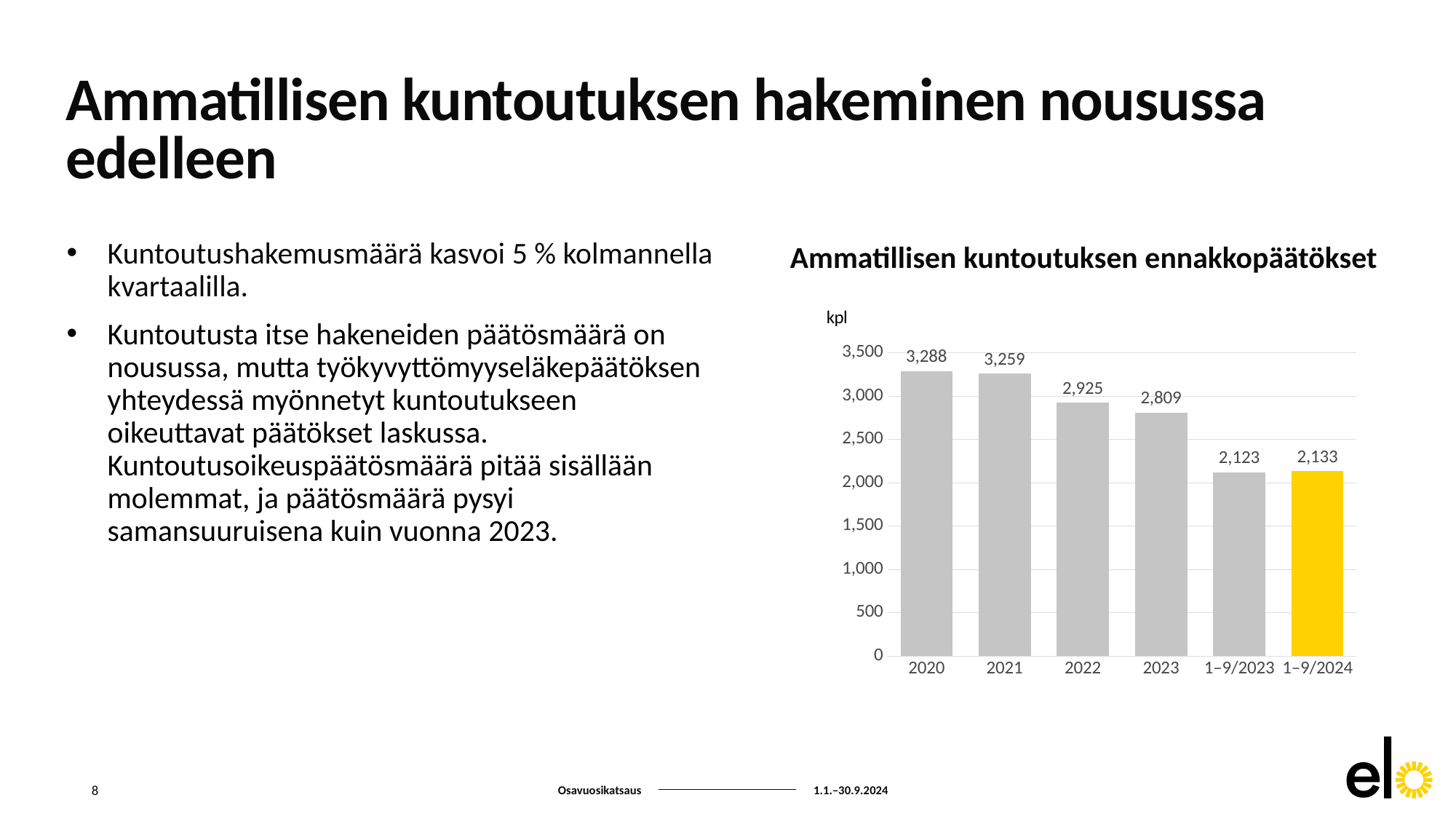
Which is larger, the value for 2021 or the value for 2023? 2021 What kind of chart is shown on the slide? bar chart What is the difference between the values for 1–9/2024 and 1–9/2023? 10 What is the value for 1–9/2024? 2,133 How many categories are shown on the x axis? 6 What is the title of the chart? Ammatillisen kuntoutuksen ennakkopäätökset What is the value for 2020? 3,288 Which category has the lowest value? 1–9/2023 Is the value for 2023 greater or less than 3,000? less Which category has the highest value? 2020 What is the value for 2022? 2,925 What is the difference between the values for 2022 and 2023? 116